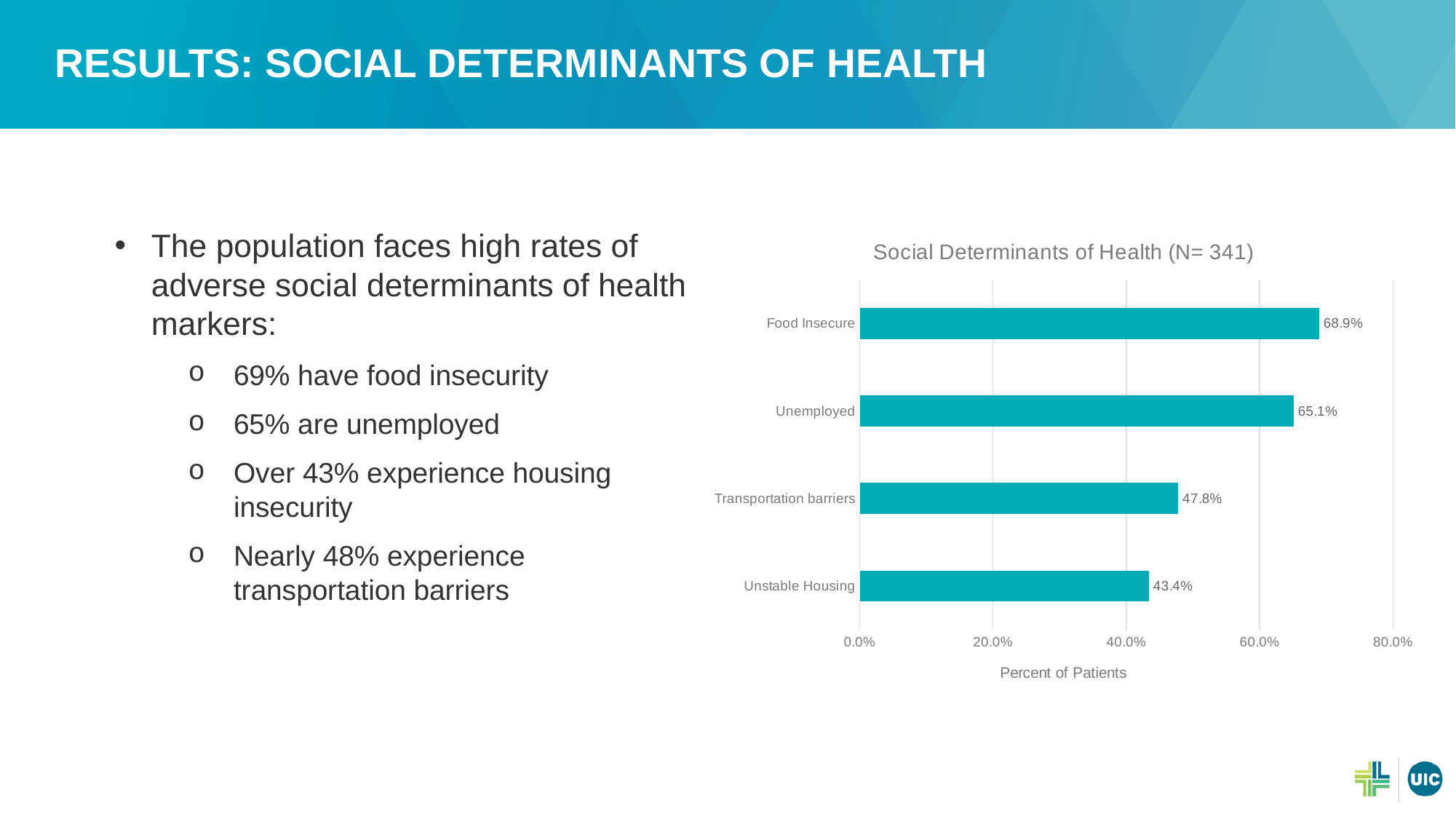
What is the value for Food Insecure? 68.9% What is the value for Transportation barriers? 47.8% What is the value for Unemployed? 65.1% What is the difference between the values for Transportation barriers and Unstable Housing? 4.4% Is the value for Unstable Housing greater or less than 40.0%? greater Which category has the highest value? Food Insecure Which is larger, the value for Unemployed or the value for Transportation barriers? Unemployed What is the value for Unstable Housing? 43.4% What kind of chart is shown on the slide? Bar chart What is the difference between the values for Food Insecure and Unstable Housing? 25.5% How many categories are shown in the chart? 4 Which category has the lowest value? Unstable Housing